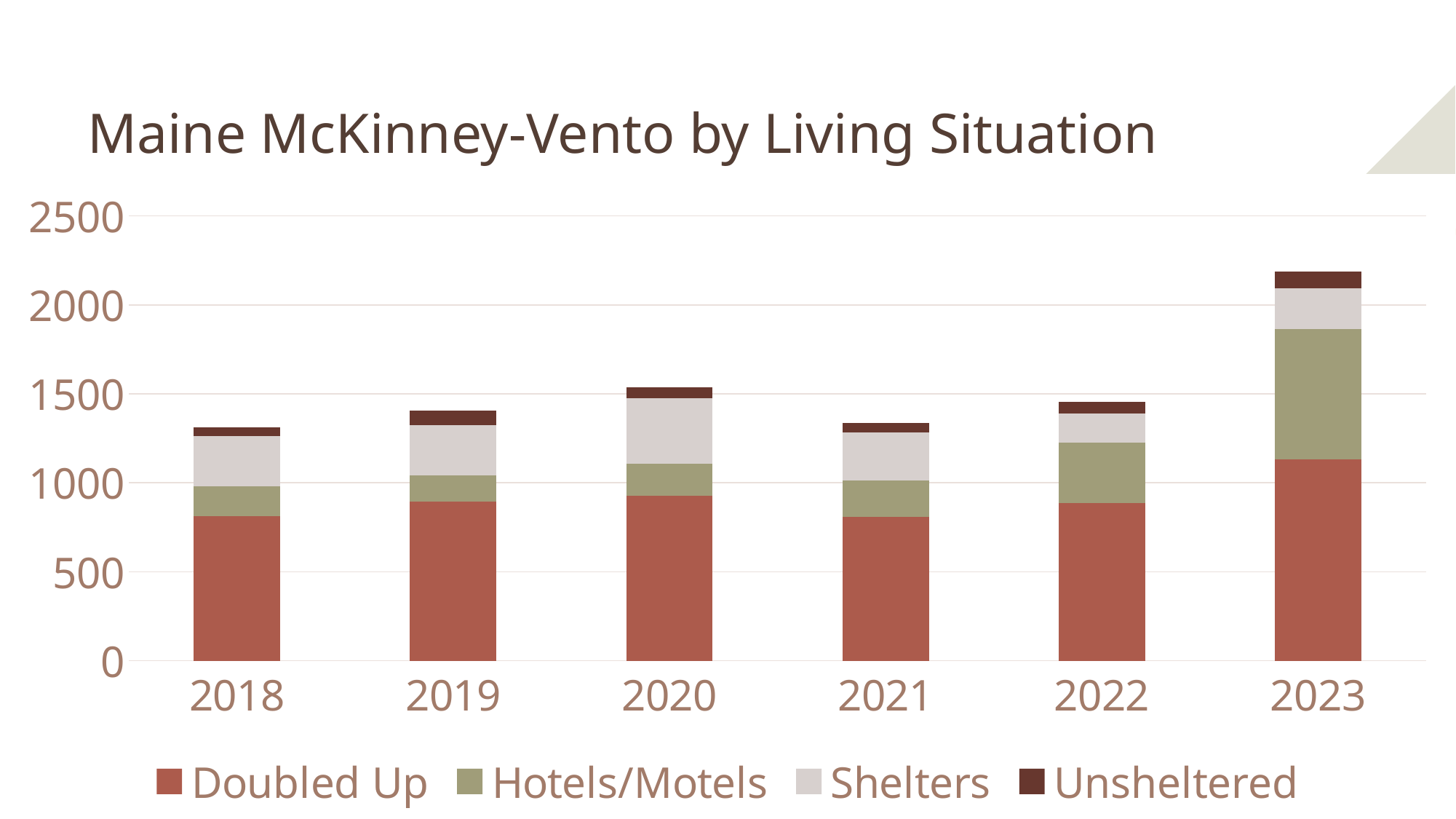
Does the total bar rise or fall from 2022 to 2023? rise How many series does the legend list? 4 Which year has the larger total bar, 2022 or 2023? 2023 What is the title of the chart? Maine McKinney-Vento by Living Situation Is the total for 2023 greater or less than 2000? greater Is the total for 2018 greater or less than 1500? less Is the Doubled Up value for 2018 greater or less than 1000? less How many years are shown on the x axis? 6 Which year has the larger Hotels/Motels segment, 2018 or 2023? 2023 Which year has the highest total bar? 2023 What kind of chart is shown on the slide? Stacked bar chart